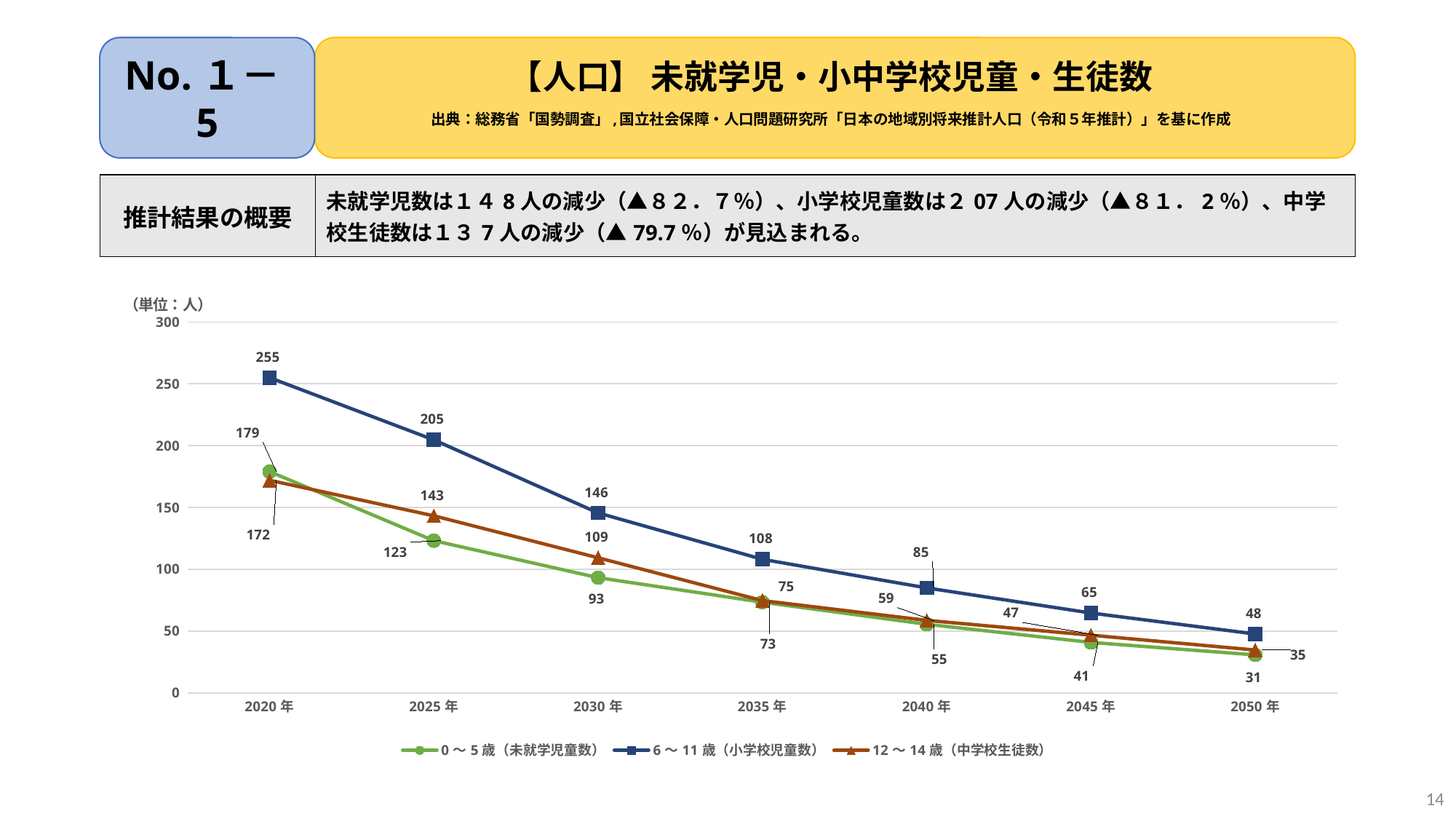
In 2045年, which is larger: 0～5歳（未就学児童数） or 12～14歳（中学校生徒数）? 12～14歳（中学校生徒数） What is the value for 6～11歳（小学校児童数） in 2020年? 255 Which series has the highest value in 2030年? 6～11歳（小学校児童数） Do the values for 6～11歳（小学校児童数） rise or fall from 2020年 to 2050年? Fall What is the value for 12～14歳（中学校生徒数） in 2040年? 59 What is the value for 0～5歳（未就学児童数） in 2050年? 31 What is the value for 12～14歳（中学校生徒数） in 2025年? 143 What is the difference between the 6～11歳（小学校児童数） values in 2020年 and 2050年? 207 What unit is indicated above the chart? （単位：人） How many years are plotted along the x axis? 7 What kind of chart is shown on the slide? Line chart How many series does the legend list? 3